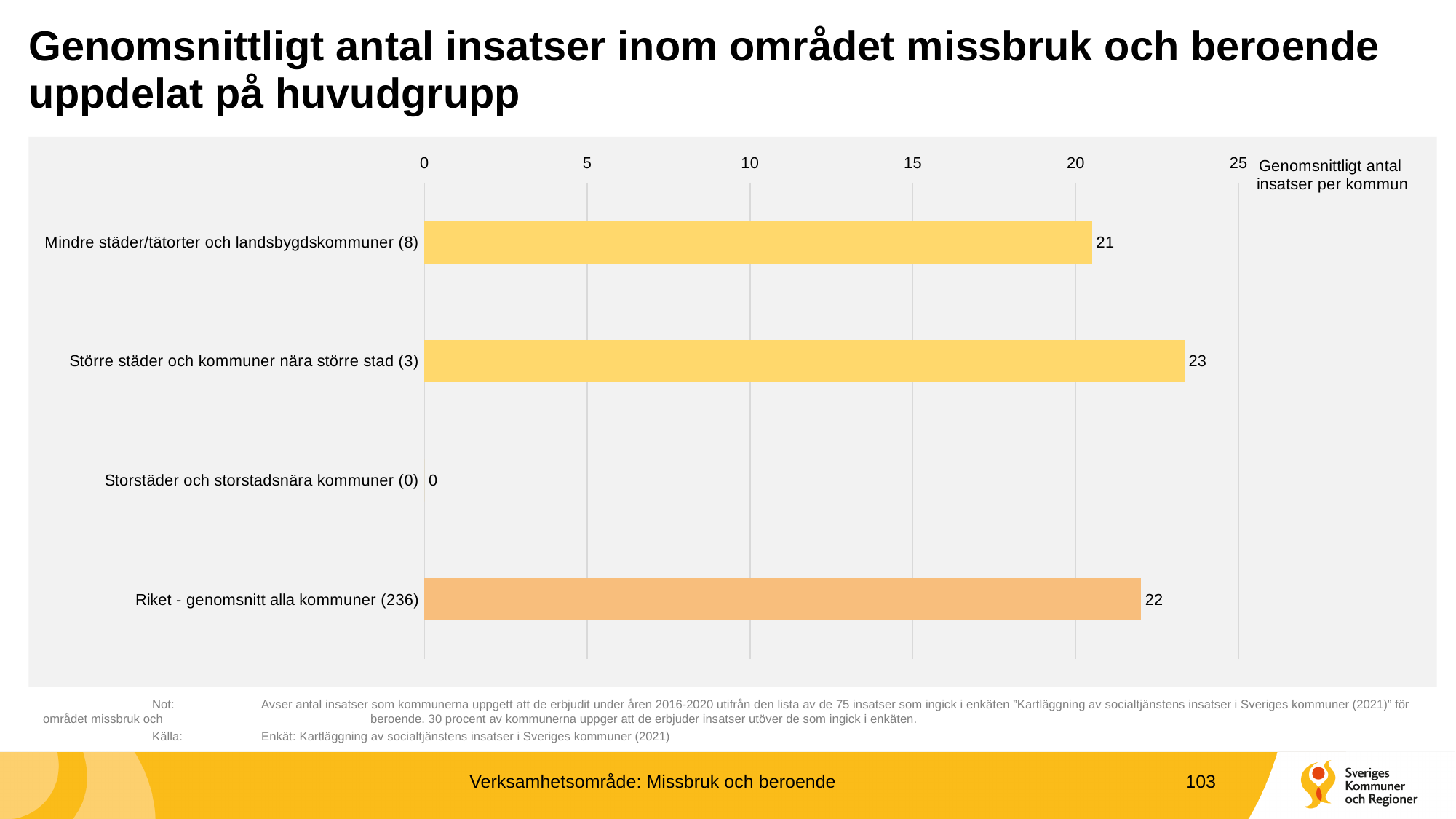
What is the difference between the values for Större städer och kommuner nära större stad (3) and Mindre städer/tätorter och landsbygdskommuner (8)? 2 What is the value for Större städer och kommuner nära större stad (3)? 23 What is the value for Riket - genomsnitt alla kommuner (236)? 22 Which category has the lowest value? Storstäder och storstadsnära kommuner (0) What is the value for Mindre städer/tätorter och landsbygdskommuner (8)? 21 What kind of chart is shown on the slide? bar chart What is the label shown at the top right of the chart describing the axis? Genomsnittligt antal insatser per kommun Which is larger: the value for Riket - genomsnitt alla kommuner (236) or the value for Mindre städer/tätorter och landsbygdskommuner (8)? Riket - genomsnitt alla kommuner (236) Is the value for Större städer och kommuner nära större stad (3) greater or less than 20? greater How many categories are shown on the chart? 4 Which category has the highest value? Större städer och kommuner nära större stad (3) What is the value for Storstäder och storstadsnära kommuner (0)? 0